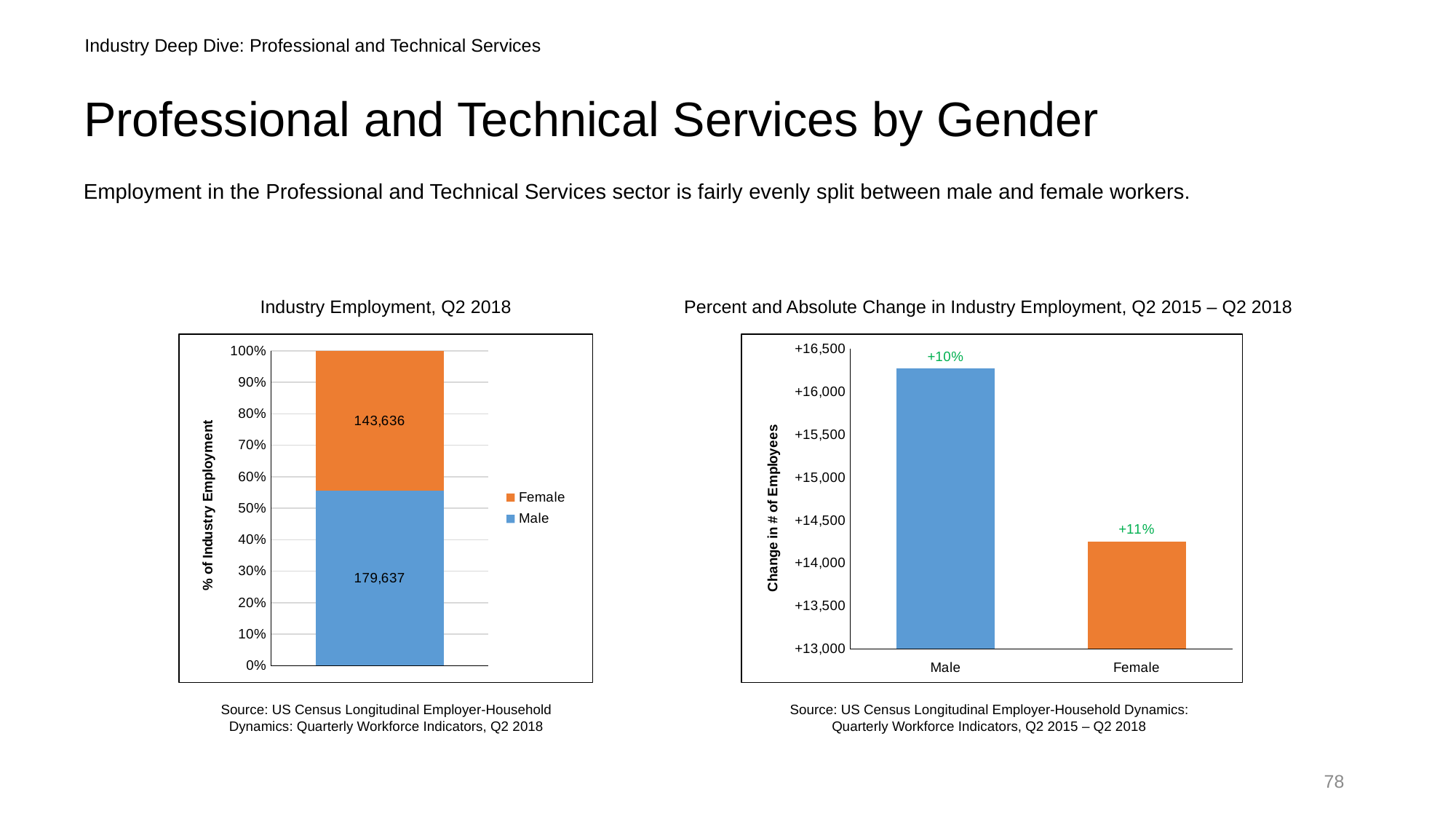
In the 'Percent and Absolute Change in Industry Employment, Q2 2015 – Q2 2018' chart, what percent change is labelled for Female? +11% In the 'Industry Employment, Q2 2018' chart, how many series does the legend list? 2 In the 'Percent and Absolute Change in Industry Employment, Q2 2015 – Q2 2018' chart, which category has the highest change in number of employees? Male In the 'Industry Employment, Q2 2018' chart, what is the value shown for Female? 143,636 What kind of chart is the 'Industry Employment, Q2 2018' chart? Stacked bar chart In the 'Percent and Absolute Change in Industry Employment, Q2 2015 – Q2 2018' chart, is the change in number of employees for Female greater or less than +14,500? less In the 'Industry Employment, Q2 2018' chart, what is the value shown for Male? 179,637 In the 'Percent and Absolute Change in Industry Employment, Q2 2015 – Q2 2018' chart, is the change in number of employees for Male greater or less than +16,000? greater In the 'Percent and Absolute Change in Industry Employment, Q2 2015 – Q2 2018' chart, what percent change is labelled for Male? +10% In the 'Industry Employment, Q2 2018' chart, what is the total of the stacked bar (Male plus Female)? 323,273 In the 'Industry Employment, Q2 2018' chart, what is the difference between the Male and Female values? 36,001 In the 'Industry Employment, Q2 2018' chart, which is larger, the Male value or the Female value? Male